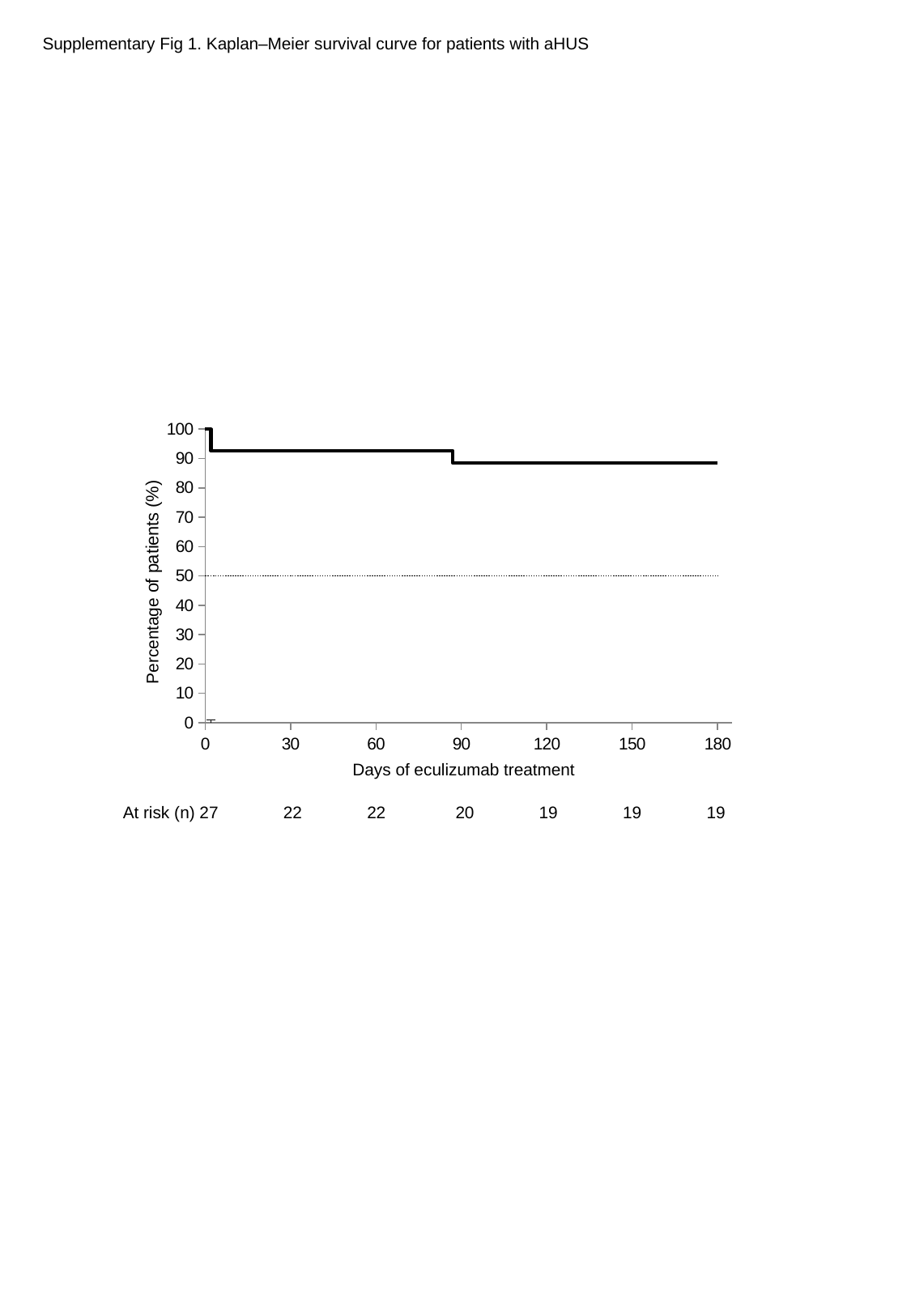
What is the difference between the number at risk at day 0 and at day 30? 5 At which time point is the number of patients at risk highest? Day 0 How many patients are at risk at day 90? 20 Does the survival curve rise or fall as days of treatment increase? Fall What is the title of the chart? Supplementary Fig 1. Kaplan–Meier survival curve for patients with aHUS How many at-risk time points are listed below the x axis? 7 Is the percentage of patients at day 120 greater or less than 80? greater How many patients are at risk at day 180? 19 Is the number at risk at day 60 larger or smaller than at day 120? Larger How many patients are at risk at day 0? 27 What is the label of the x axis? Days of eculizumab treatment What kind of chart is shown on the slide? Line chart (Kaplan–Meier survival curve)